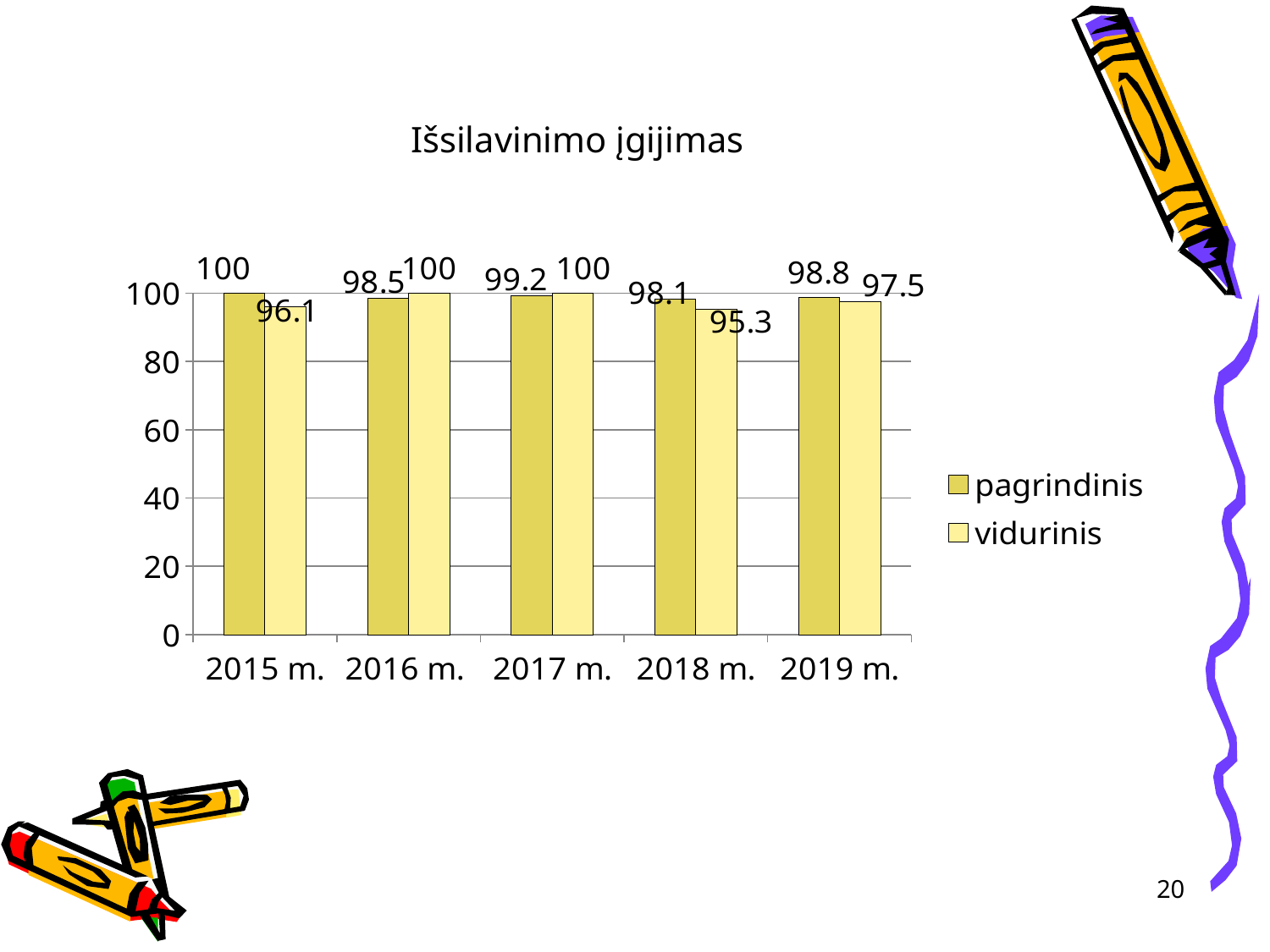
In which year is the pagrindinis value lowest? 2018 m. What is the value for vidurinis in 2015 m.? 96.1 In which year is the vidurinis value lowest? 2018 m. What is the difference between the pagrindinis and vidurinis values in 2018 m.? 2.8 What is the value for pagrindinis in 2015 m.? 100 Which is larger in 2019 m., pagrindinis or vidurinis? pagrindinis How many series does the legend list? 2 How many years are shown on the x axis? 5 What is the title of the chart? Išsilavinimo įgijimas What is the value for vidurinis in 2018 m.? 95.3 What is the value for pagrindinis in 2019 m.? 98.8 What kind of chart is shown? bar chart